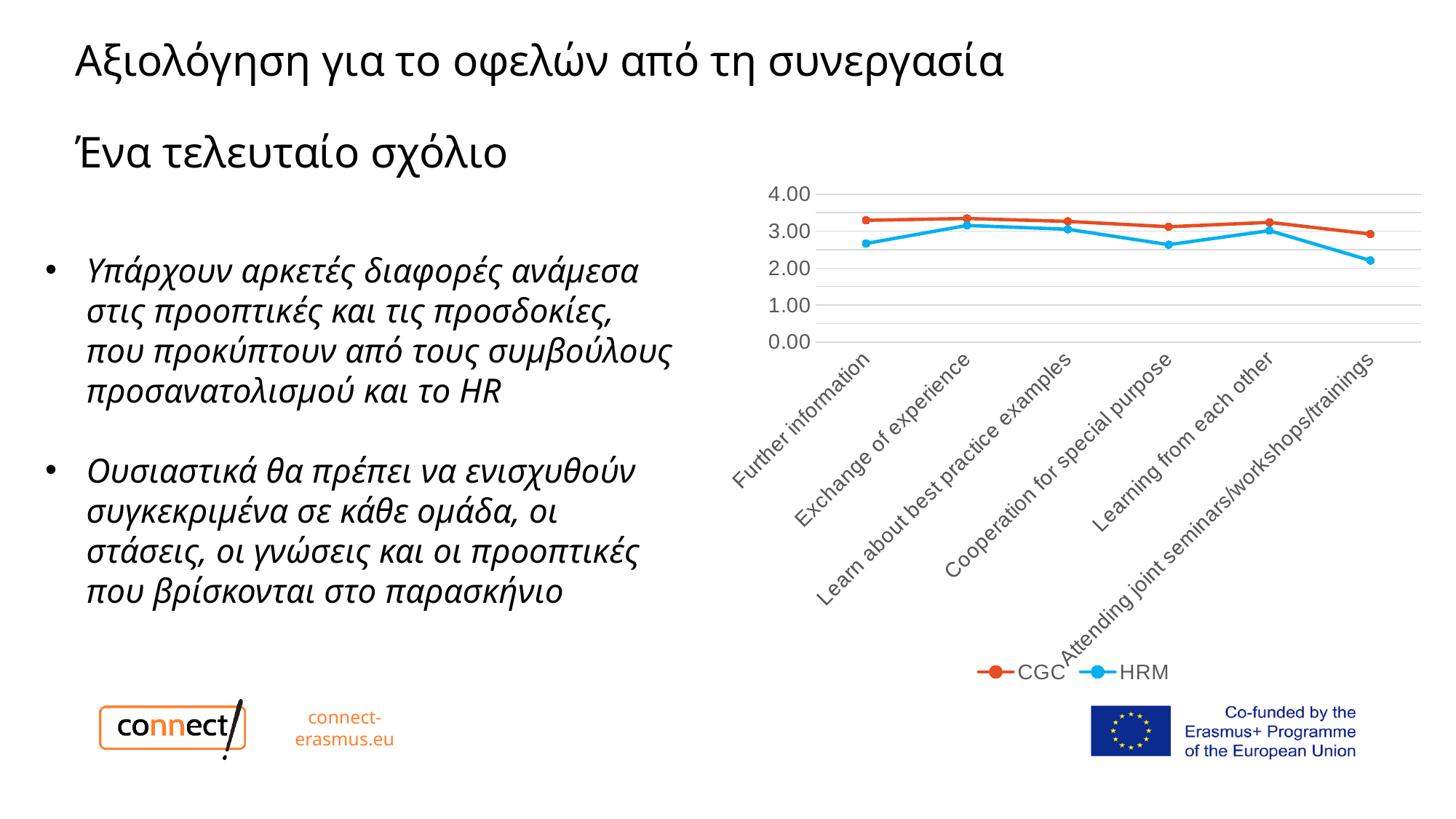
For Attending joint seminars/workshops/trainings, which series has the larger value, CGC or HRM? CGC How many categories are plotted along the x axis of the chart? 6 Is the CGC value for Further information greater or less than 3.00? greater Which series is drawn in blue in the chart? HRM Is the HRM value for Cooperation for special purpose greater or less than 3.00? less What kind of chart is shown on the slide? line chart Which category has the lowest HRM value? Attending joint seminars/workshops/trainings Is the HRM value for Further information greater or less than 3.00? less Does the HRM line rise or fall from Learning from each other to Attending joint seminars/workshops/trainings? fall How many series does the chart's legend list? 2 For Further information, which series has the larger value, CGC or HRM? CGC